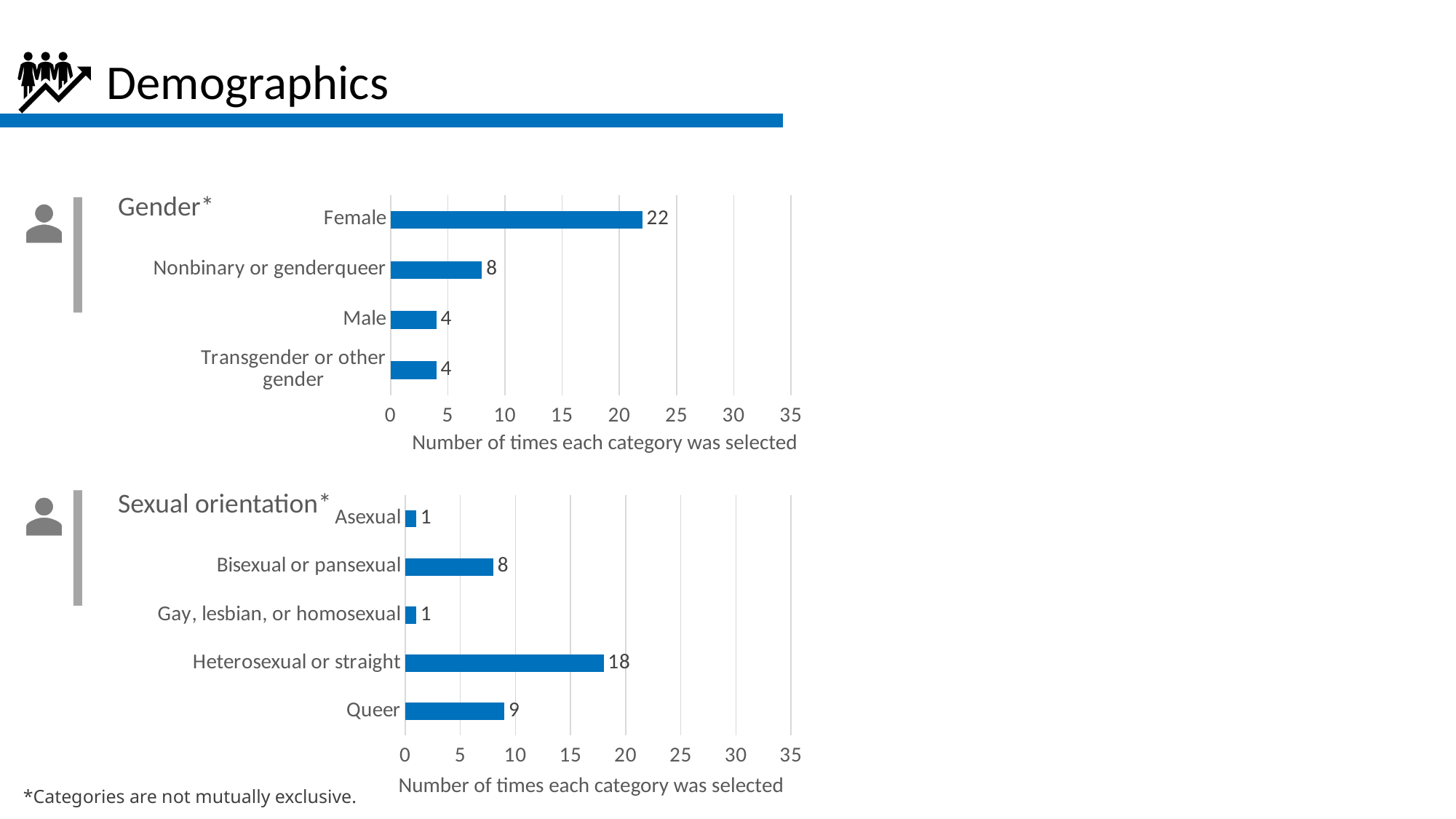
In the Sexual orientation chart, which category has the highest value? Heterosexual or straight In the Sexual orientation chart, what is the value for Heterosexual or straight? 18 In the Gender chart, how many categories are shown? 4 In the Gender chart, what is the difference between the values for Female and Male? 18 In the Gender chart, which category has the highest value? Female In the Gender chart, what is the value for Female? 22 In the Gender chart, what is the value for Nonbinary or genderqueer? 8 In the Sexual orientation chart, what is the difference between the values for Heterosexual or straight and Bisexual or pansexual? 10 What kind of chart is the Gender chart? Bar chart In the Sexual orientation chart, what is the value for Queer? 9 In the Sexual orientation chart, how many categories are shown? 5 In the Sexual orientation chart, which is larger, the value for Bisexual or pansexual or the value for Queer? Queer